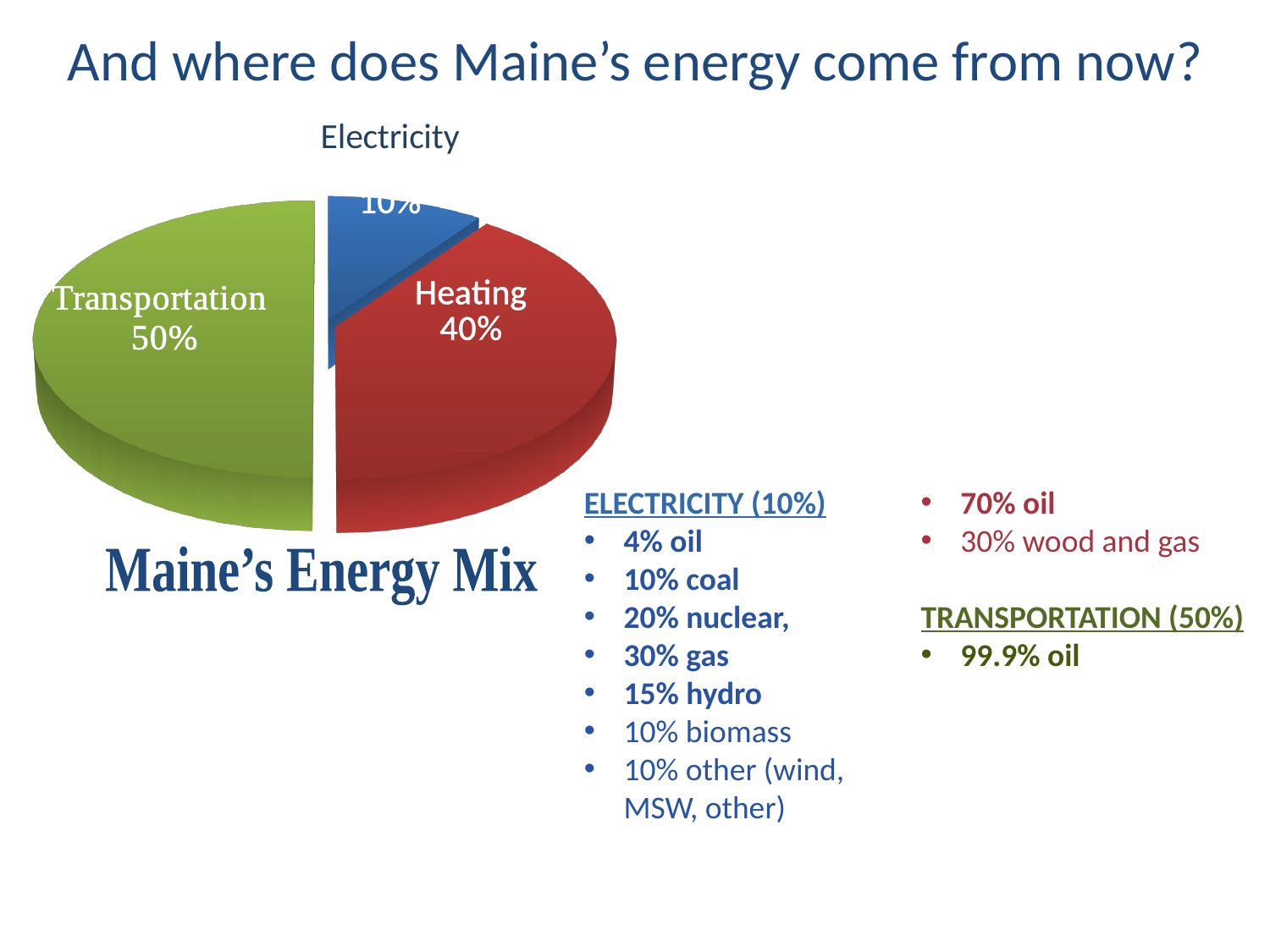
What is the difference in percentage points between Transportation and Heating? 10 What is the title of the pie chart? Maine's Energy Mix What kind of chart is shown on the slide? pie chart What colour is the Transportation slice? green What is the difference in percentage points between Heating and Electricity? 30 Which is larger, the Heating slice or the Electricity slice? Heating What share of Maine's energy mix does Electricity account for? 10% Which category has the smallest slice of the pie? Electricity Which category has the largest slice of the pie? Transportation What share of Maine's energy mix does Heating account for? 40% What share of Maine's energy mix does Transportation account for? 50% How many slices does the pie chart have? 3